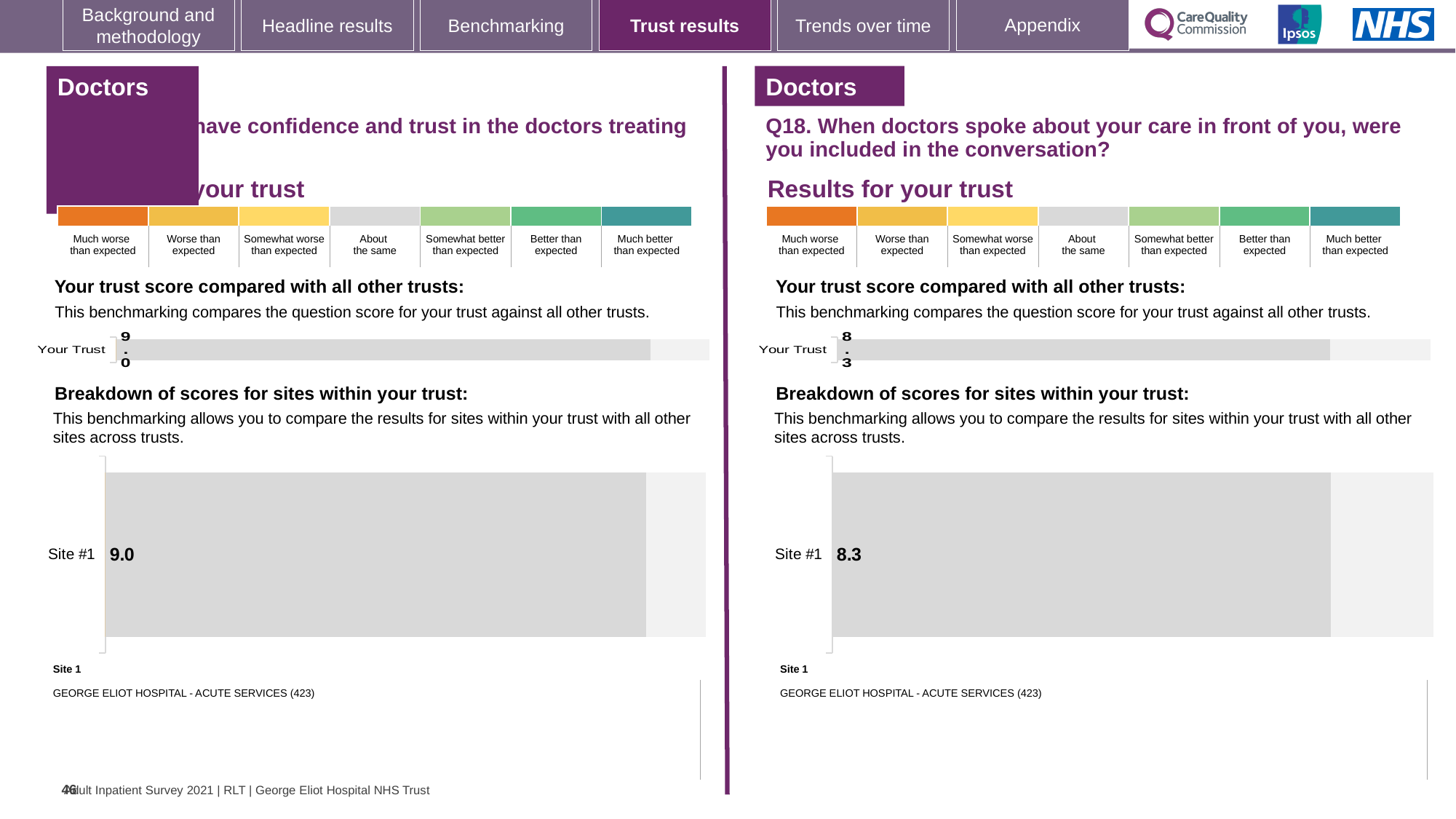
On the left half of the slide, what is the score shown for Site #1 in the breakdown of scores for sites within your trust? 9.0 How many sites are shown in the breakdown of scores chart on the right half of the slide (Q18)? 1 What is the name of Site 1 listed below the breakdown chart on the right half of the slide (Q18)? GEORGE ELIOT HOSPITAL - ACUTE SERVICES (423) What kind of chart is used for the breakdown of scores for sites within your trust on the right half of the slide (Q18)? Bar chart How many sites are shown in the breakdown of scores chart on the left half of the slide? 1 On the right half of the slide (Q18), what is the 'Your Trust' score in the chart comparing your trust score with all other trusts? 8.3 On the left half of the slide, what is the 'Your Trust' score in the chart comparing your trust score with all other trusts? 9.0 On the right half of the slide (Q18), what is the label of the category shown in the 'Your trust score compared with all other trusts' chart? Your Trust On the right half of the slide (Q18), what is the score shown for Site #1 in the breakdown of scores for sites within your trust? 8.3 What is the difference between the Site #1 score on the left half of the slide and the Site #1 score on the right half (Q18)? 0.7 Which Site #1 score is larger: the one on the left half of the slide or the one on the right half (Q18)? The left half (9.0)